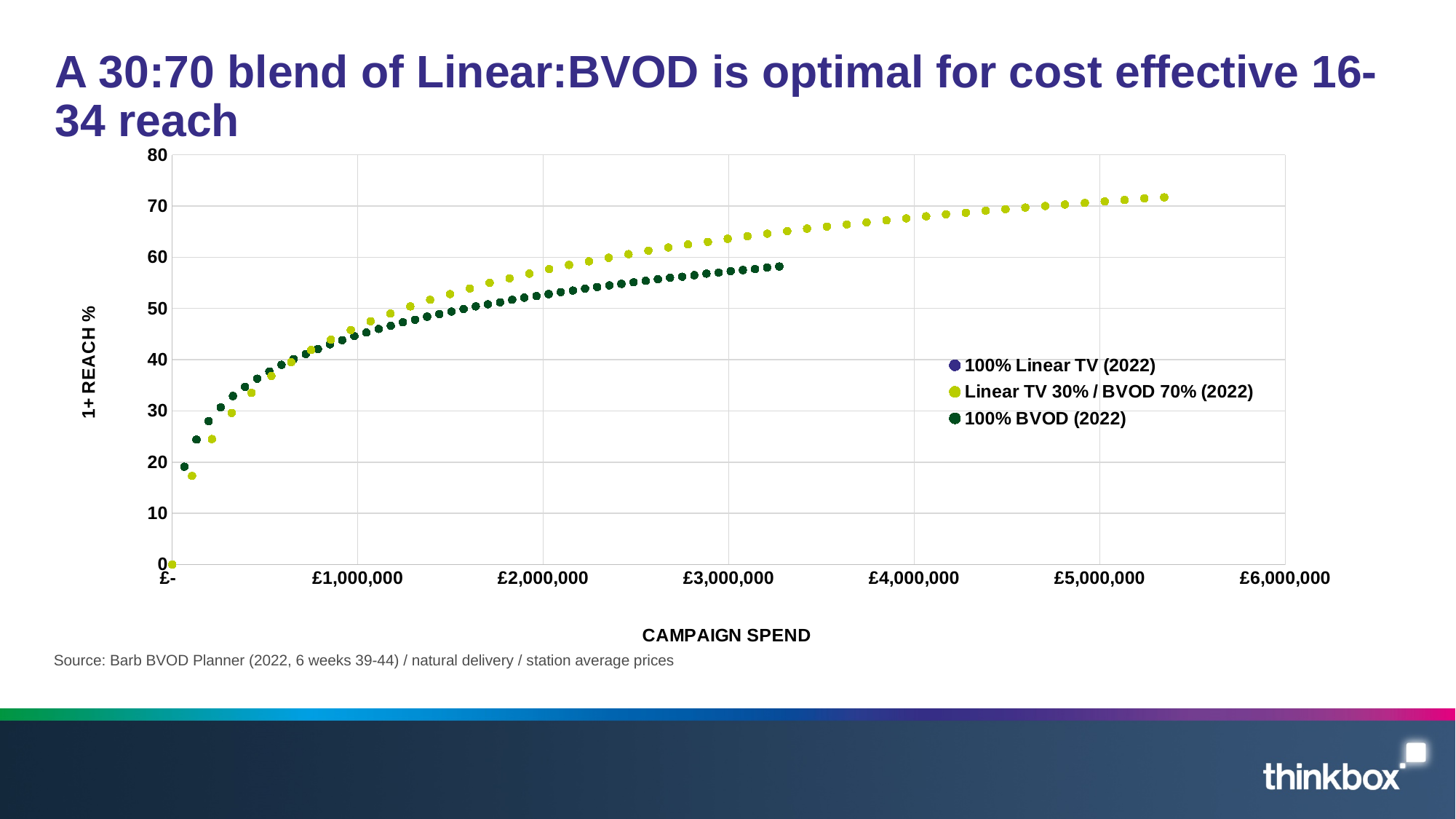
How many series does the chart legend list? 3 Is the 1+ reach % for the Linear TV 30% / BVOD 70% (2022) series at a campaign spend of £5,000,000 greater or less than 60? greater At a campaign spend of £2,000,000, which series has the higher 1+ reach %: Linear TV 30% / BVOD 70% (2022) or 100% BVOD (2022)? Linear TV 30% / BVOD 70% (2022) Which plotted series reaches the highest 1+ reach % on the chart? Linear TV 30% / BVOD 70% (2022) What is the title of the chart's horizontal axis? CAMPAIGN SPEND Is the highest 1+ reach % reached by the Linear TV 30% / BVOD 70% (2022) series greater or less than 80? less Is the 1+ reach % for the 100% BVOD (2022) series at a campaign spend of £3,000,000 greater or less than 60? less What kind of chart is shown on the slide? Scatter chart What is the title of the chart's vertical axis? 1+ REACH % Does 1+ reach % rise or fall as campaign spend increases for the Linear TV 30% / BVOD 70% (2022) series? Rise Does 1+ reach % rise or fall as campaign spend increases for the 100% BVOD (2022) series? Rise